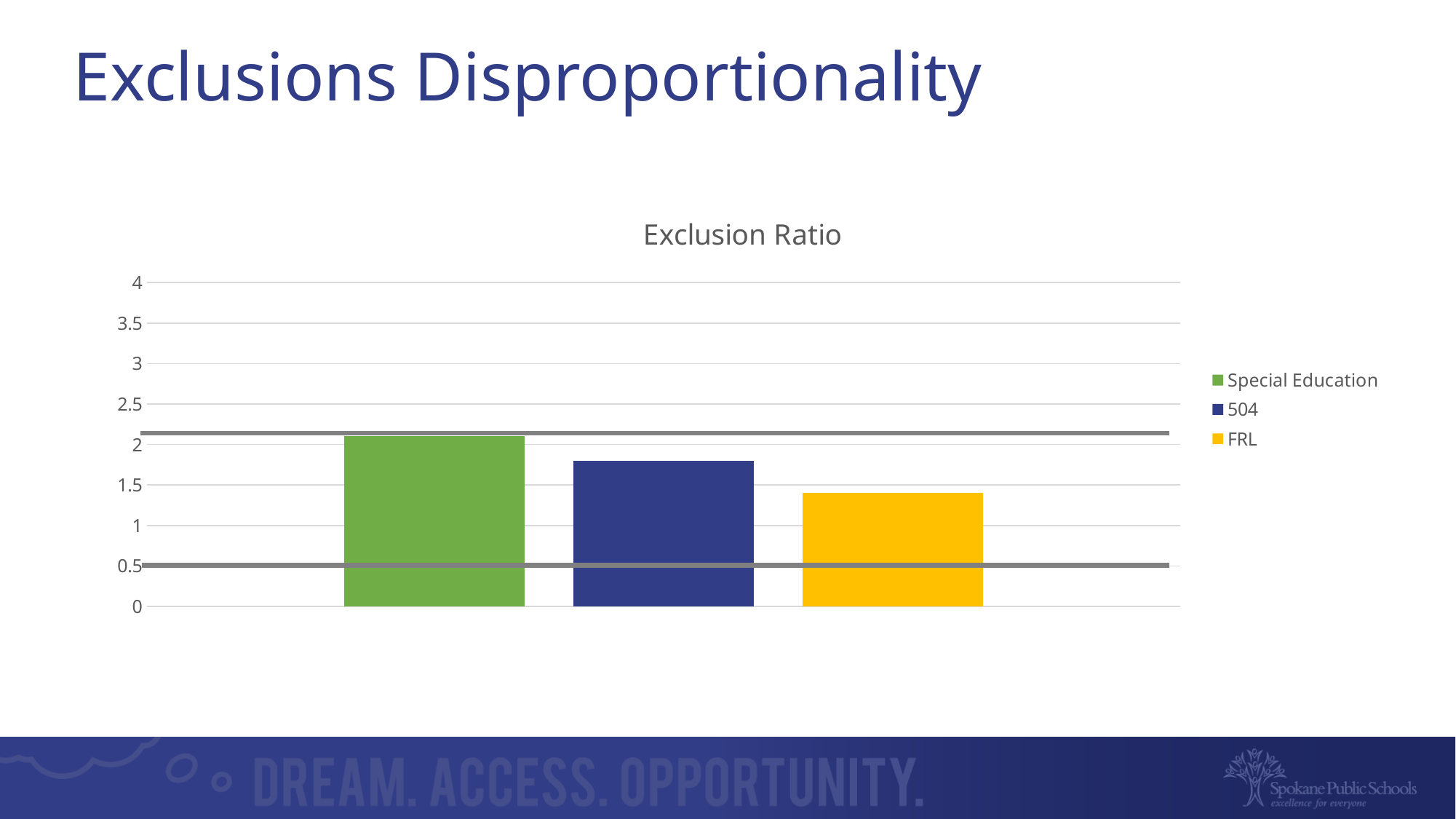
Is the value for Special Education greater or less than 2? greater Which series has the lowest exclusion ratio? FRL Is the value for FRL greater or less than 1.5? less How many series does the legend list? 3 What colour is the bar for FRL? yellow Which is larger, the exclusion ratio for Special Education or for 504? Special Education Which is larger, the exclusion ratio for 504 or for FRL? 504 Is the value for 504 greater or less than 2? less What is the title of the chart? Exclusion Ratio Do the bar values rise or fall from left to right across the chart? fall What type of chart is shown on the slide? bar chart Which series has the highest exclusion ratio? Special Education